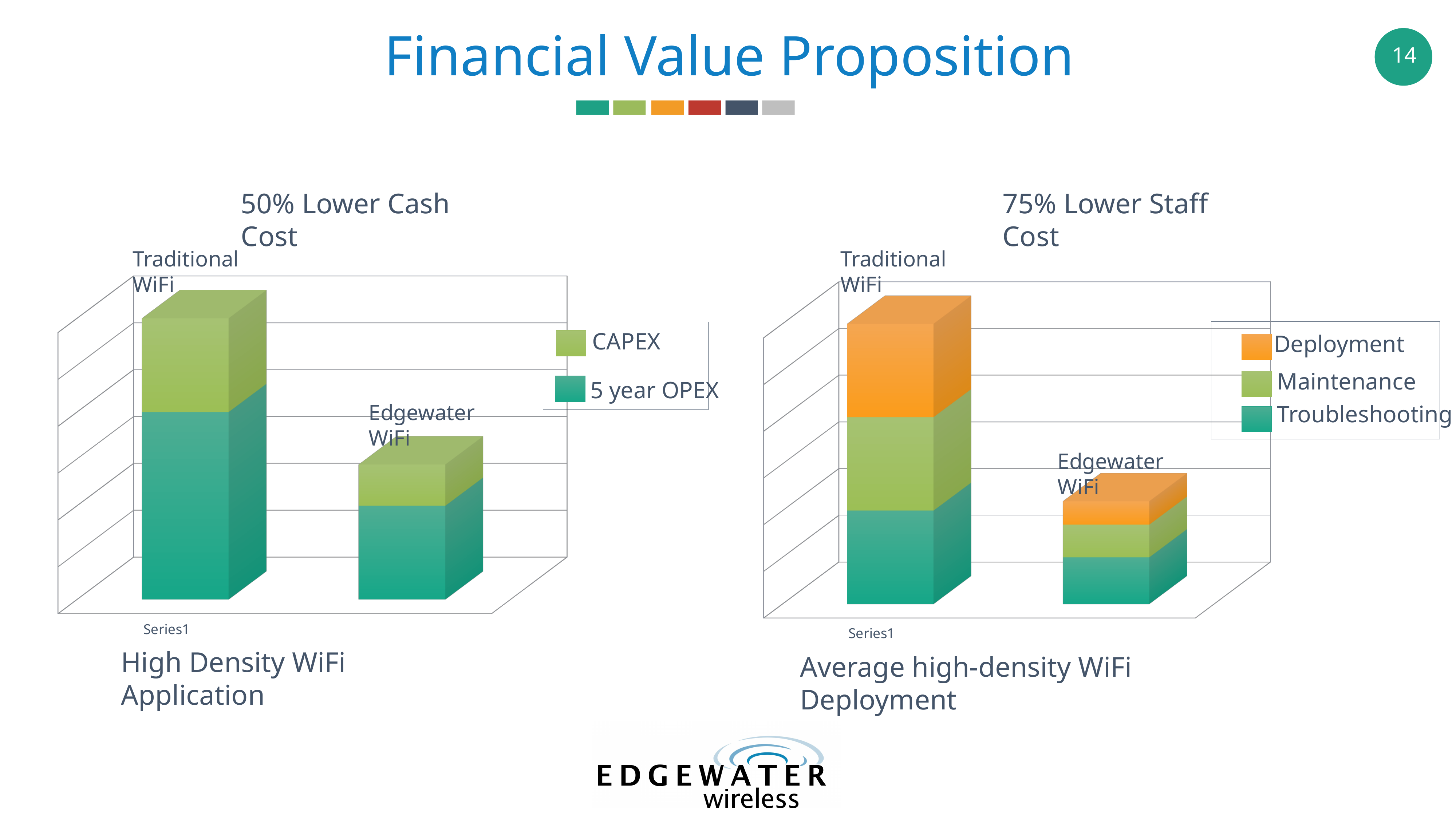
What kind of chart is the left chart titled "50% Lower Cash Cost"? Stacked bar chart In the left chart ("50% Lower Cash Cost"), which bar is taller, Traditional WiFi or Edgewater WiFi? Traditional WiFi In the right chart ("75% Lower Staff Cost"), which bar is the highest? Traditional WiFi In the right chart ("75% Lower Staff Cost"), how many bars are plotted? 2 In the left chart ("50% Lower Cash Cost"), how many series does the legend list? 2 In the left chart ("50% Lower Cash Cost"), how many bars are plotted? 2 In the left chart ("50% Lower Cash Cost"), which series is larger for Traditional WiFi, CAPEX or 5 year OPEX? 5 year OPEX In the left chart ("50% Lower Cash Cost"), what are the two legend entries? CAPEX and 5 year OPEX In the right chart ("75% Lower Staff Cost"), which bar is the lowest? Edgewater WiFi In the right chart ("75% Lower Staff Cost"), which series is shown in orange? Deployment What kind of chart is the right chart titled "75% Lower Staff Cost"? Stacked bar chart In the right chart ("75% Lower Staff Cost"), how many series does the legend list? 3